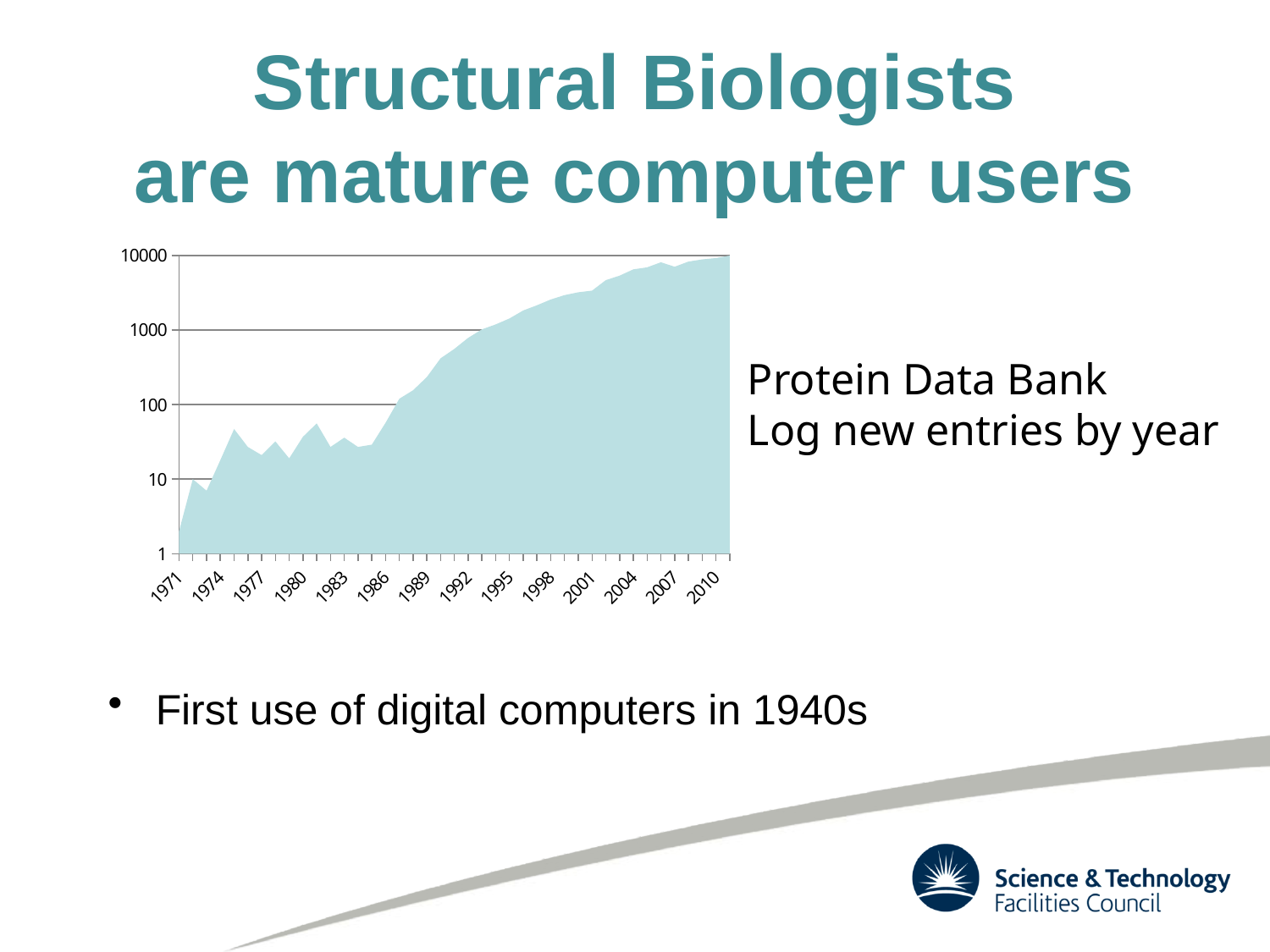
Is the value for 1998 greater or less than 1000? greater Is the value for 1977 greater or less than 100? less Is the value for 1992 greater or less than 100? greater Which year has the highest value in the chart? 2011 What is the highest value labelled on the y axis? 10000 How many year labels are shown on the x axis? 14 Do the values in the chart generally rise or fall from 1971 to 2010? rise What kind of chart is shown on the slide? area chart Which year has the lowest value in the chart? 1971 Which year has the larger value, 1986 or 2001? 2001